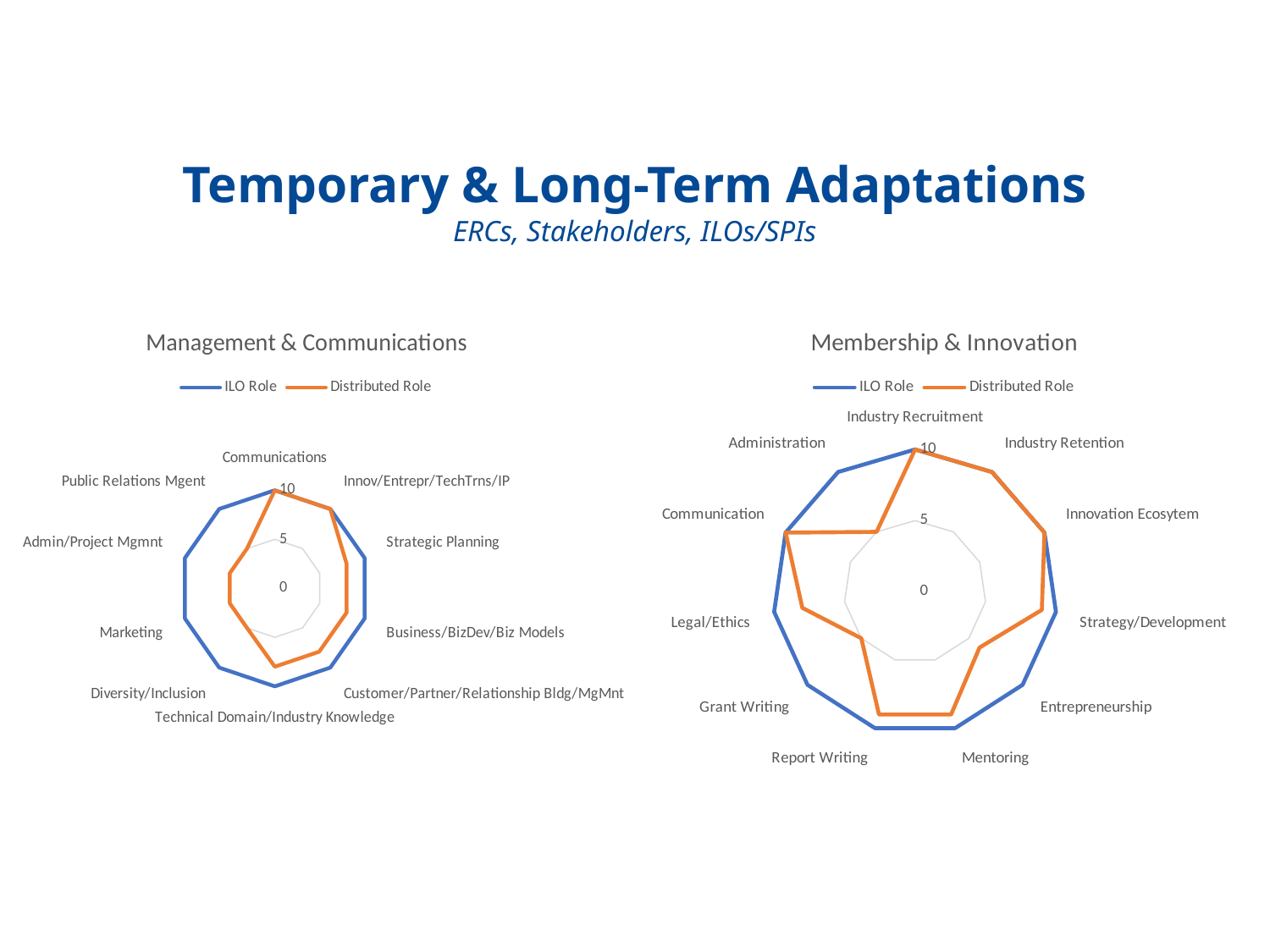
On the Management & Communications chart, is the Distributed Role value for Customer/Partner/Relationship Bldg/MgMnt greater or less than 5? greater On the Membership & Innovation chart, is the Distributed Role value for Legal/Ethics greater or less than 5? greater How many categories are plotted on the Membership & Innovation chart? 11 What kind of chart is the Management & Communications chart? Radar chart On the Management & Communications chart, what is the ILO Role value for Communications? 10 How many series does the legend of the Membership & Innovation chart list? 2 What colour is the Distributed Role series on the Membership & Innovation chart? Orange How many categories are plotted on the Management & Communications chart? 10 On the Management & Communications chart, which series has the larger value for Admin/Project Mgmnt, ILO Role or Distributed Role? ILO Role On the Membership & Innovation chart, what is the Distributed Role value for Industry Recruitment? 10 On the Membership & Innovation chart, which series has the larger value for Grant Writing, ILO Role or Distributed Role? ILO Role